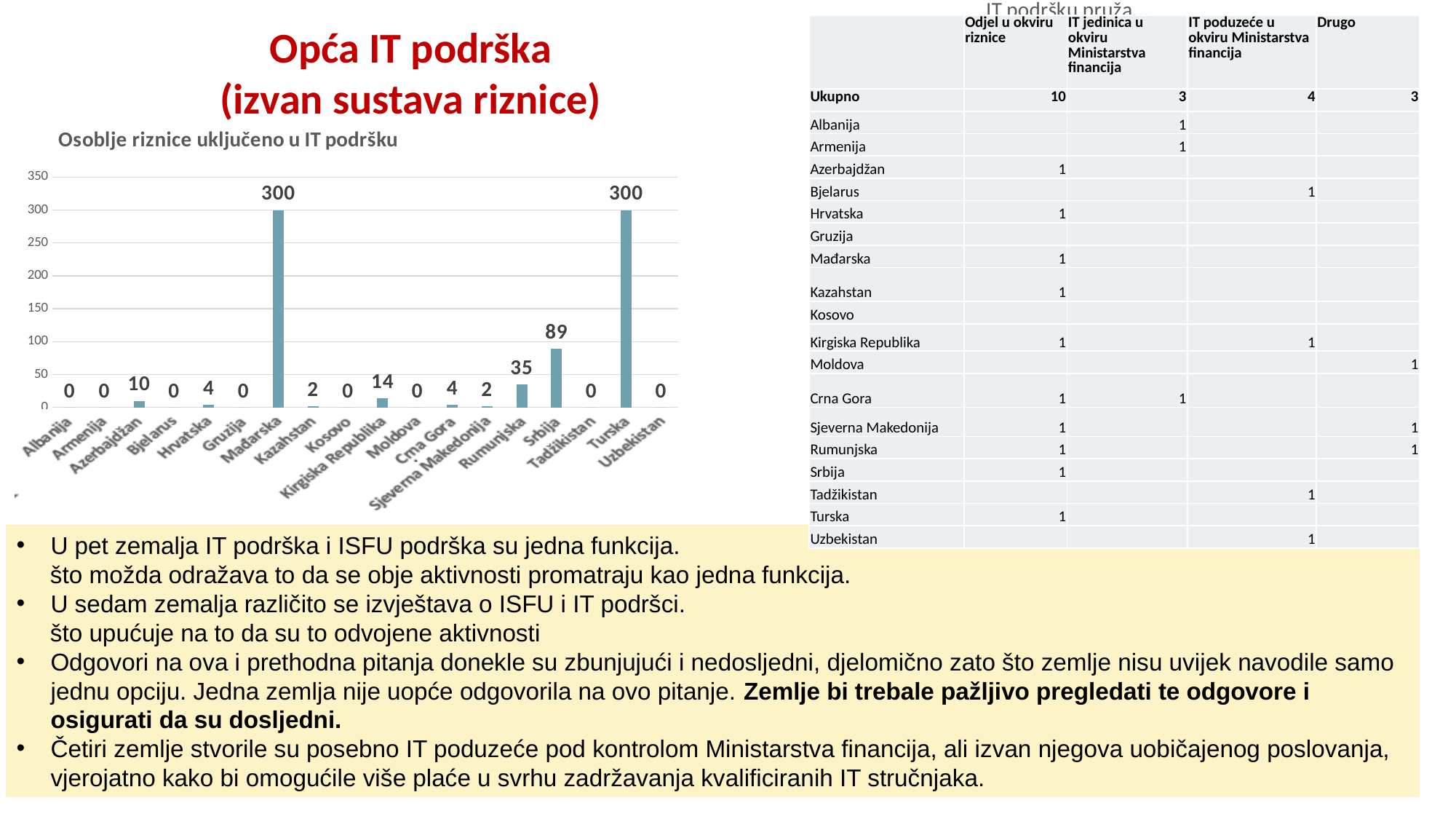
How many countries are shown on the x axis of the chart? 18 What is the difference between the values for Srbija and Rumunjska? 54 What is the value for Azerbajdžan in the chart? 10 Which has a larger value, Hrvatska or Rumunjska? Rumunjska What type of chart is "Osoblje riznice uključeno u IT podršku"? Bar chart What is the value for Mađarska in the chart? 300 What is the value for Rumunjska in the chart? 35 What is the highest value shown in the chart? 300 What is the value for Srbija in the chart "Osoblje riznice uključeno u IT podršku"? 89 What is the difference between the values for Turska and Srbija? 211 Which has a larger value, Kirgiska Republika or Azerbajdžan? Kirgiska Republika What is the value for Kirgiska Republika in the chart? 14